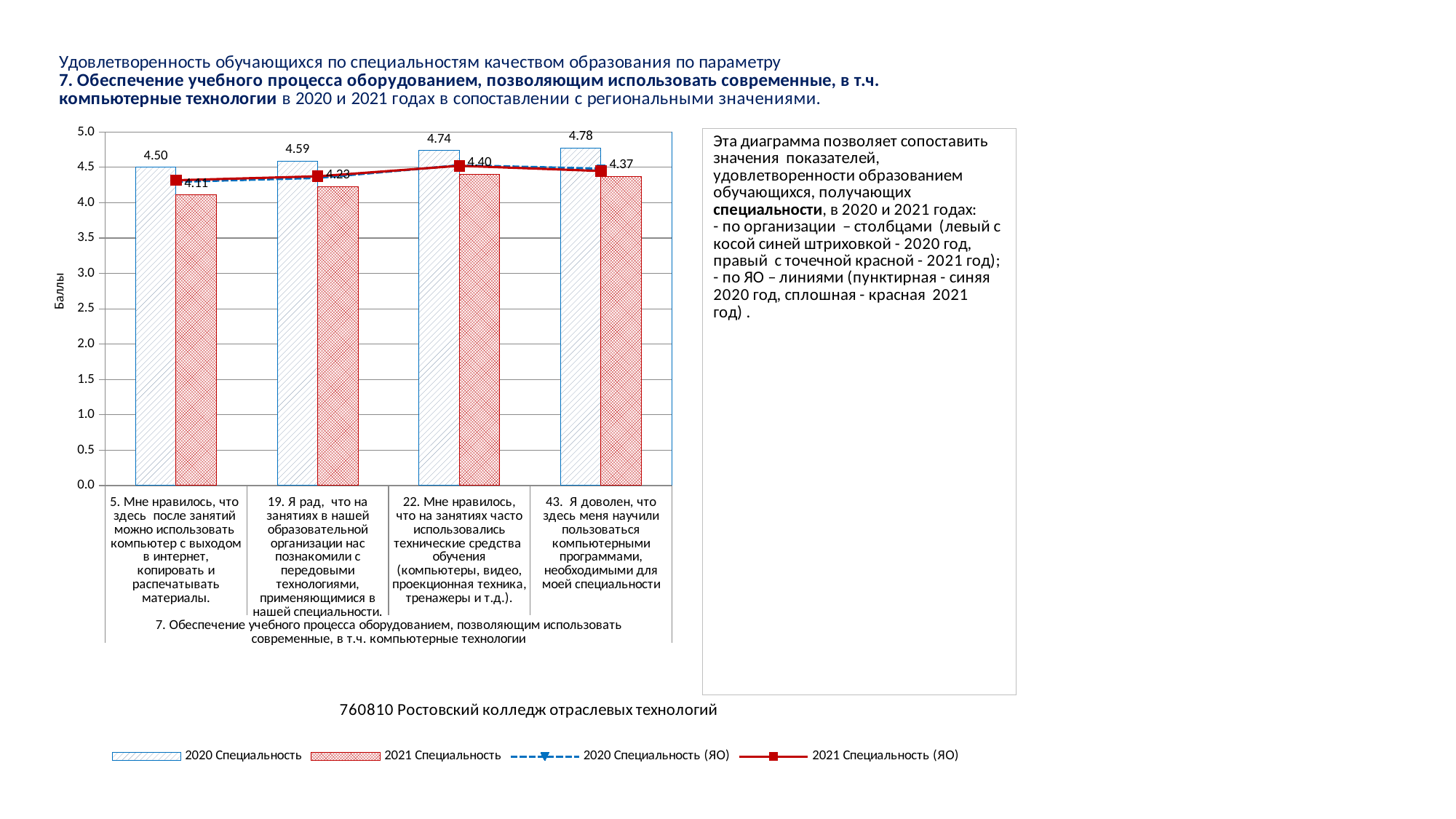
What is the label of the vertical axis? Баллы Which category has the highest 2020 Специальность value? 43. Я доволен, что здесь меня научили пользоваться компьютерными программами, необходимыми для моей специальности Which category has the lowest 2021 Специальность value? 5. Мне нравилось, что здесь после занятий можно использовать компьютер с выходом в интернет, копировать и распечатывать материалы. What is the value of the 2020 Специальность bar for category 5 ("Мне нравилось, что здесь после занятий можно использовать компьютер...")? 4.50 Is the 2021 Специальность value for category 5 greater or less than 4.5? less What is the value of the 2020 Специальность bar for category 43 ("Я доволен, что здесь меня научили пользоваться компьютерными программами...")? 4.78 How many categories (questions) are shown on the x axis? 4 What is the value of the 2021 Специальность bar for category 22 ("Мне нравилось, что на занятиях часто использовались технические средства обучения...")? 4.40 How many series does the legend list? 4 Which is larger for category 43: the 2020 Специальность bar or the 2021 Специальность bar? 2020 Специальность What is the difference between the 2020 and 2021 Специальность values for category 5? 0.39 What is the value of the 2021 Специальность bar for category 19 ("Я рад, что на занятиях в нашей образовательной организации нас познакомили с передовыми технологиями...")? 4.23